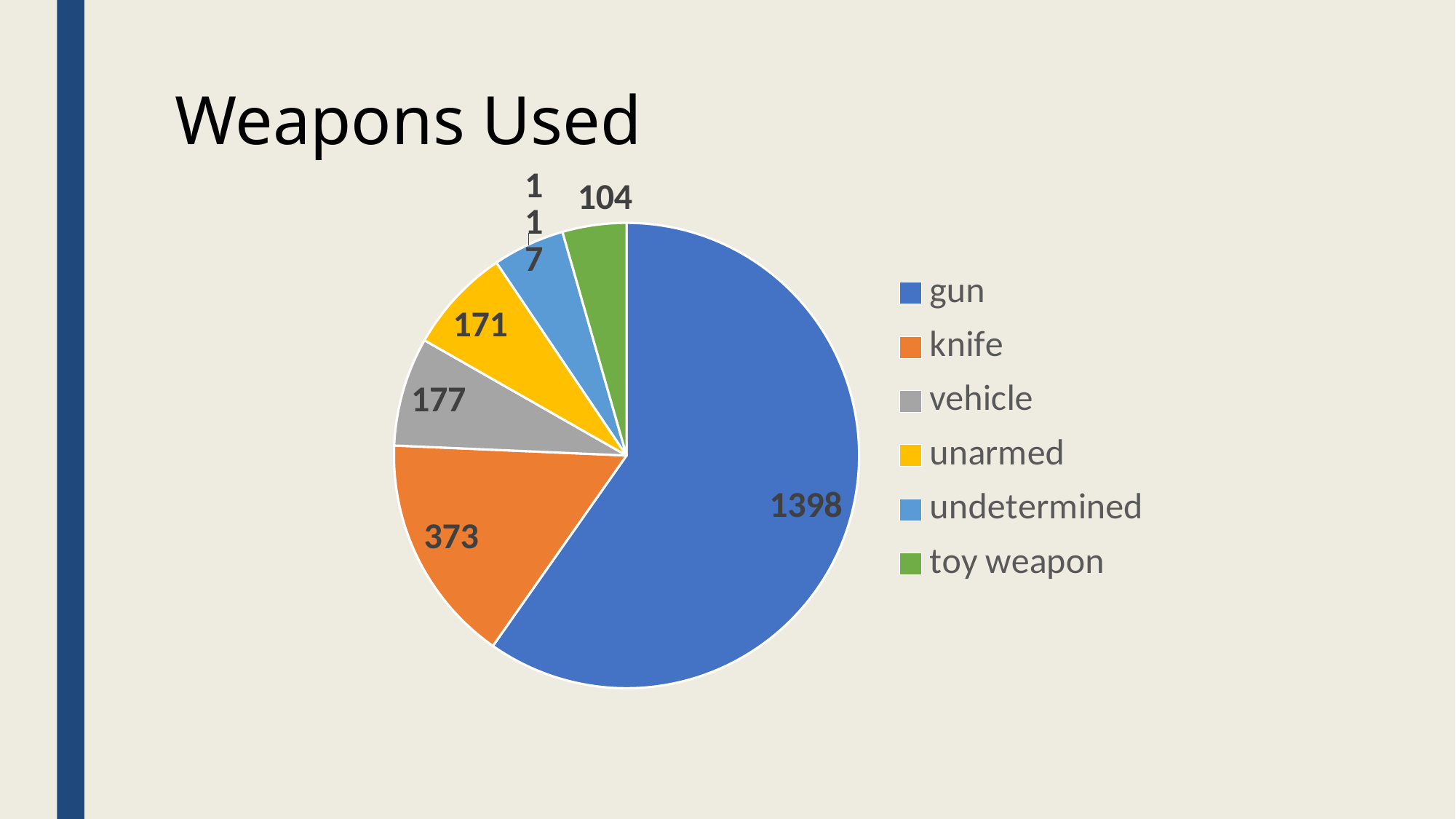
What is the value for vehicle in the Weapons Used chart? 177 Which is larger, the value for knife or the value for vehicle? knife How many categories are shown in the Weapons Used pie chart? 6 What is the value for knife in the Weapons Used chart? 373 Which category has the largest slice in the Weapons Used chart? gun What is the value for toy weapon in the Weapons Used chart? 104 What is the difference between the values for gun and knife? 1025 What type of chart is shown on the slide? pie chart What is the value for unarmed in the Weapons Used chart? 171 What is the value for gun in the Weapons Used chart? 1398 What is the title of the chart on the slide? Weapons Used Which category has the smallest slice in the Weapons Used chart? toy weapon